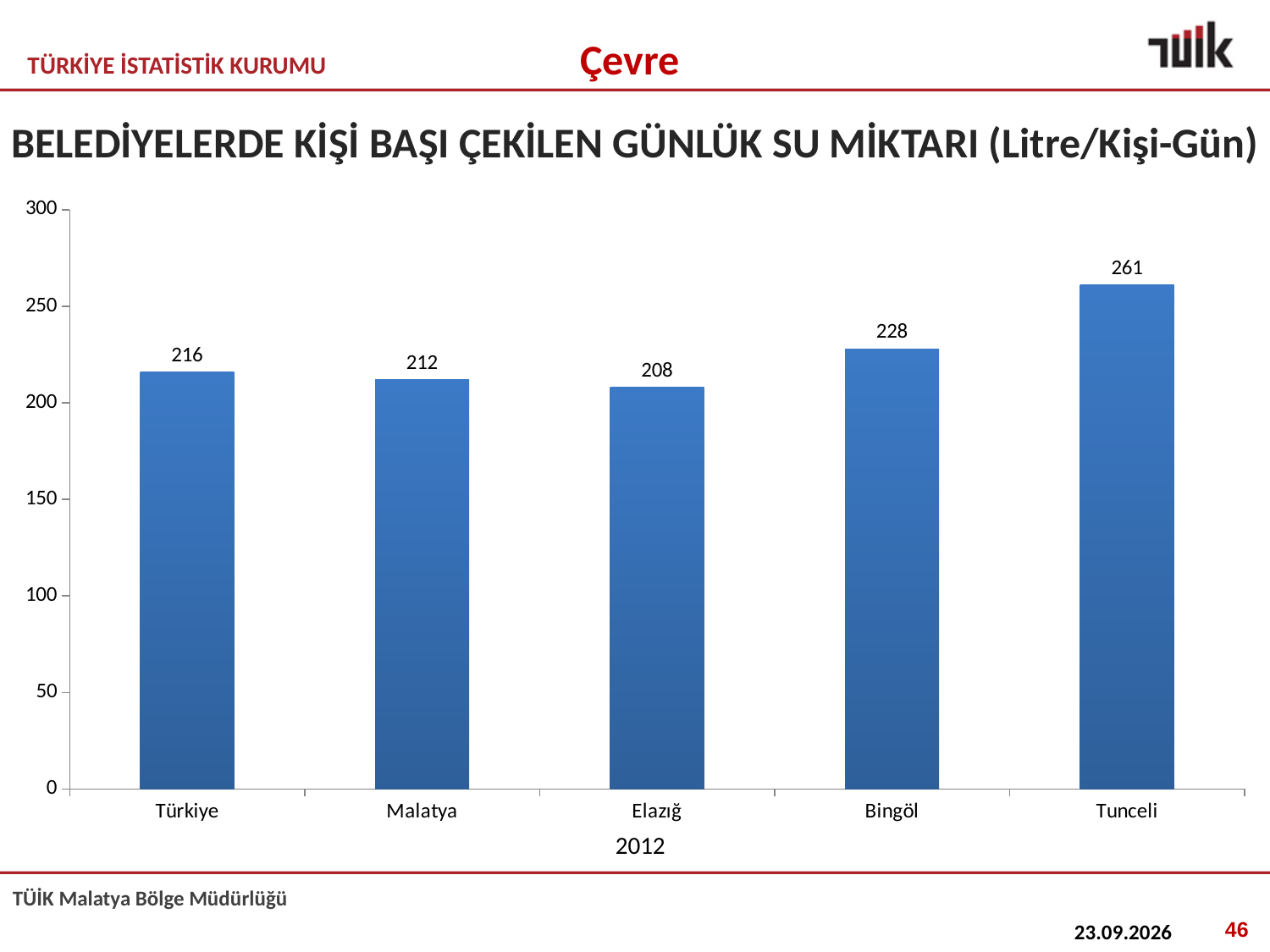
How many categories are shown on the x axis? 5 What is the difference between the values for Tunceli and Elazığ? 53 What is the value for Tunceli? 261 What year is shown as the x-axis label below the categories? 2012 What kind of chart is shown on the slide? bar chart What is the value for Türkiye? 216 Which category has the highest value? Tunceli Which is larger, the value for Türkiye or the value for Malatya? Türkiye Is the value for Bingöl greater or less than 250? less What is the difference between the values for Bingöl and Malatya? 16 What is the value for Elazığ? 208 Which category has the lowest value? Elazığ